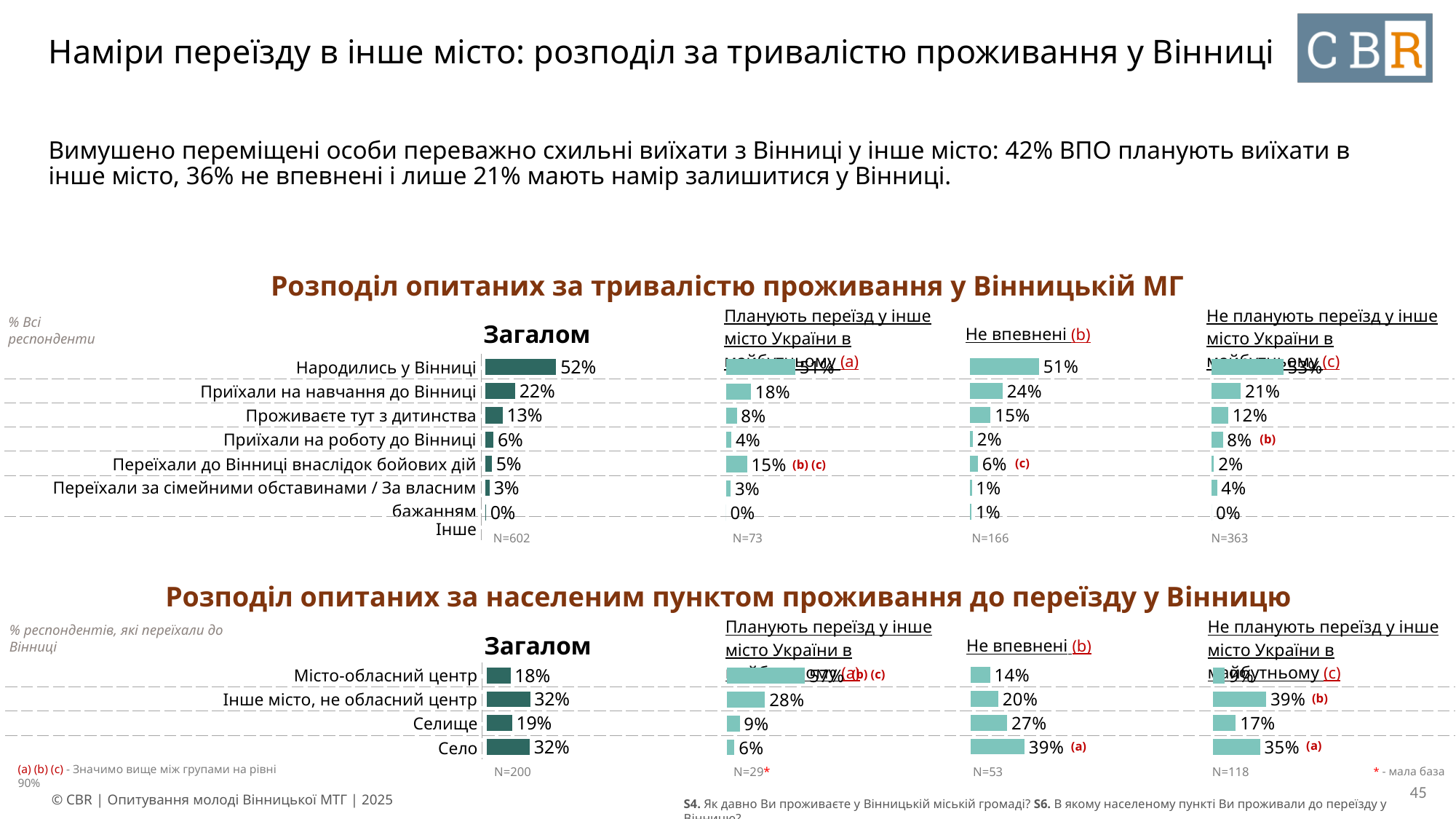
In the top chart (Розподіл опитаних за тривалістю проживання у Вінницькій МГ), what is the value for 'Народились у Вінниці' in the 'Загалом' column? 52% In the top chart, for 'Приїхали на роботу до Вінниці', which is larger: the 'Не впевнені' value or the 'Не планують переїзд' value? Не планують переїзд In the top chart, what is the value for 'Приїхали на навчання до Вінниці' in the 'Не впевнені' column? 24% What type of chart is used on this slide? Bar chart In the top chart, which category has the highest value in the 'Загалом' column? Народились у Вінниці In the top chart, what is the difference between 'Народились у Вінниці' and 'Приїхали на навчання до Вінниці' in the 'Загалом' column? 30 percentage points In the bottom chart (Розподіл опитаних за населеним пунктом проживання до переїзду у Вінницю), what is the value for 'Село' in the 'Не впевнені' column? 39% How many categories are listed in the top chart? 7 In the bottom chart, which category has the highest value in the 'Не впевнені' column? Село In the top chart, what is the value for 'Переїхали до Вінниці внаслідок бойових дій' in the 'Планують переїзд у інше місто України в майбутньому' column? 15% In the bottom chart, which category has the lowest value in the 'Планують переїзд у інше місто України в майбутньому' column? Село How many categories are listed in the bottom chart? 4